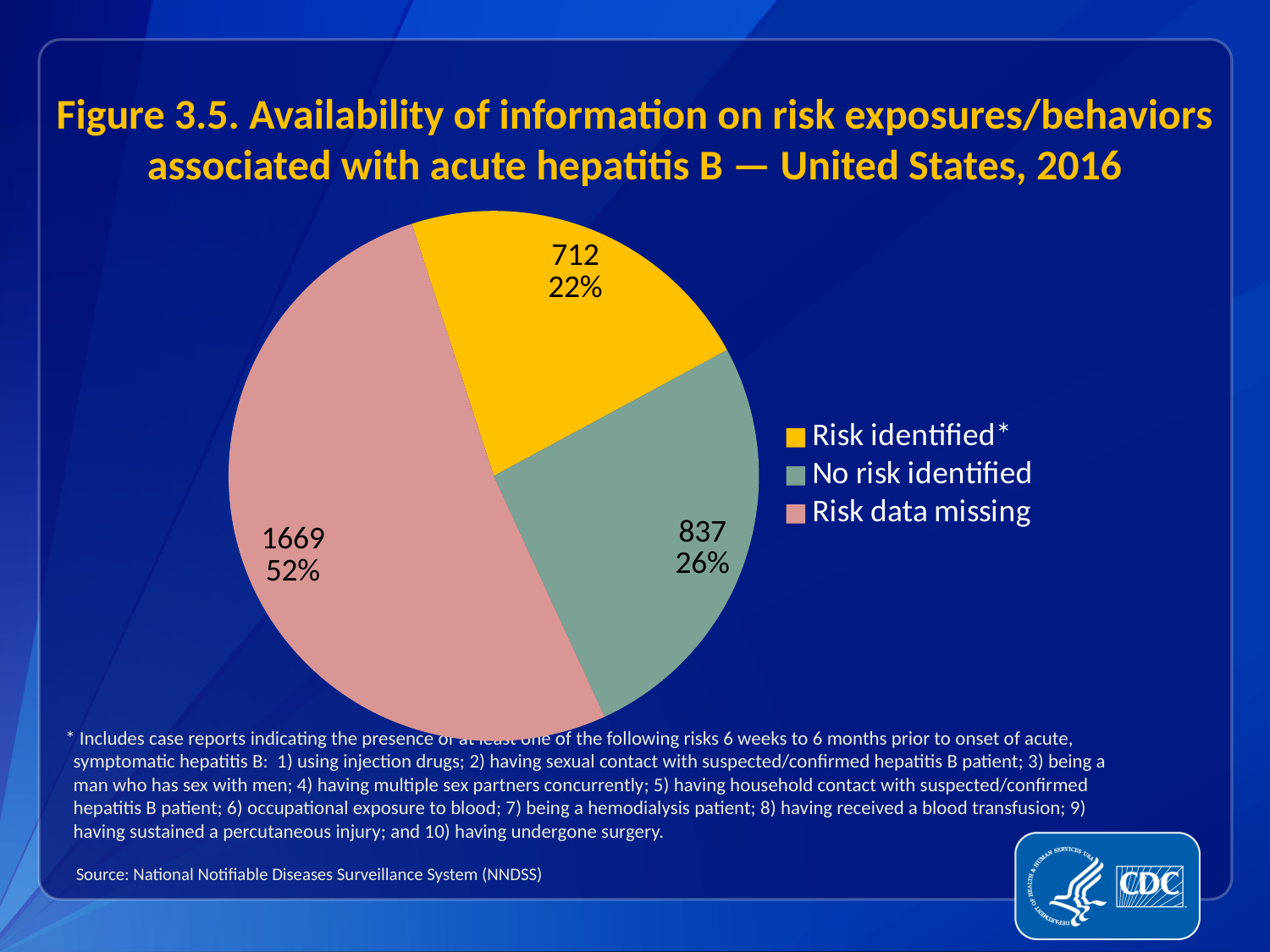
How many cases are in the "Risk identified*" slice? 712 Which category has the largest slice of the pie? Risk data missing What is the total number of cases across all three slices? 3218 Which is larger, the "No risk identified" slice or the "Risk identified*" slice? No risk identified What percentage of the pie is "Risk data missing"? 52% How many categories does the legend list? 3 How many cases are in the "Risk data missing" slice? 1669 What colour is the "Risk identified*" slice? yellow Which category has the smallest slice of the pie? Risk identified* What percentage of the pie is "No risk identified"? 26% What is the difference in cases between "Risk data missing" and "No risk identified"? 832 What kind of chart is shown on the slide? pie chart